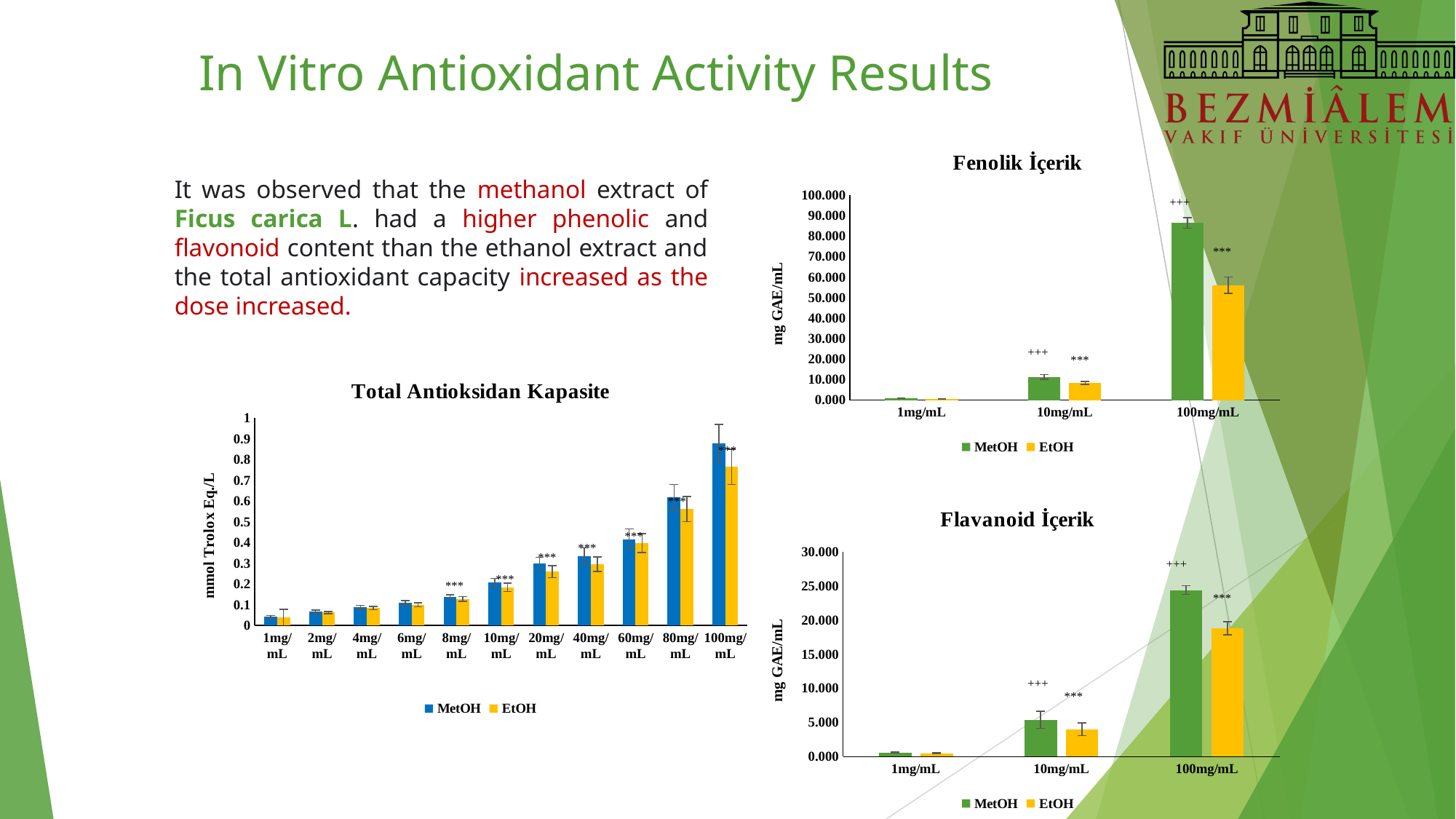
What is the y-axis label of the 'Flavanoid İçerik' chart? mg GAE/mL In the 'Fenolik İçerik' chart, which concentration has the highest MetOH value? 100mg/mL In the 'Fenolik İçerik' chart, is the EtOH value at 100mg/mL greater or less than 60.000? less In the 'Flavanoid İçerik' chart, which series is larger at 100mg/mL, MetOH or EtOH? MetOH What kind of chart is 'Fenolik İçerik'? Bar chart In the 'Total Antioksidan Kapasite' chart, how many series does the legend list? 2 In the 'Total Antioksidan Kapasite' chart, is the MetOH value at 100mg/mL greater or less than 0.8? greater In the 'Total Antioksidan Kapasite' chart, how many concentration categories are shown on the x axis? 11 In the 'Flavanoid İçerik' chart, is the MetOH value at 100mg/mL greater or less than 20.000? greater In the 'Flavanoid İçerik' chart, which concentration has the lowest EtOH value? 1mg/mL In the 'Total Antioksidan Kapasite' chart, do the MetOH values rise or fall as the concentration increases along the x axis? rise